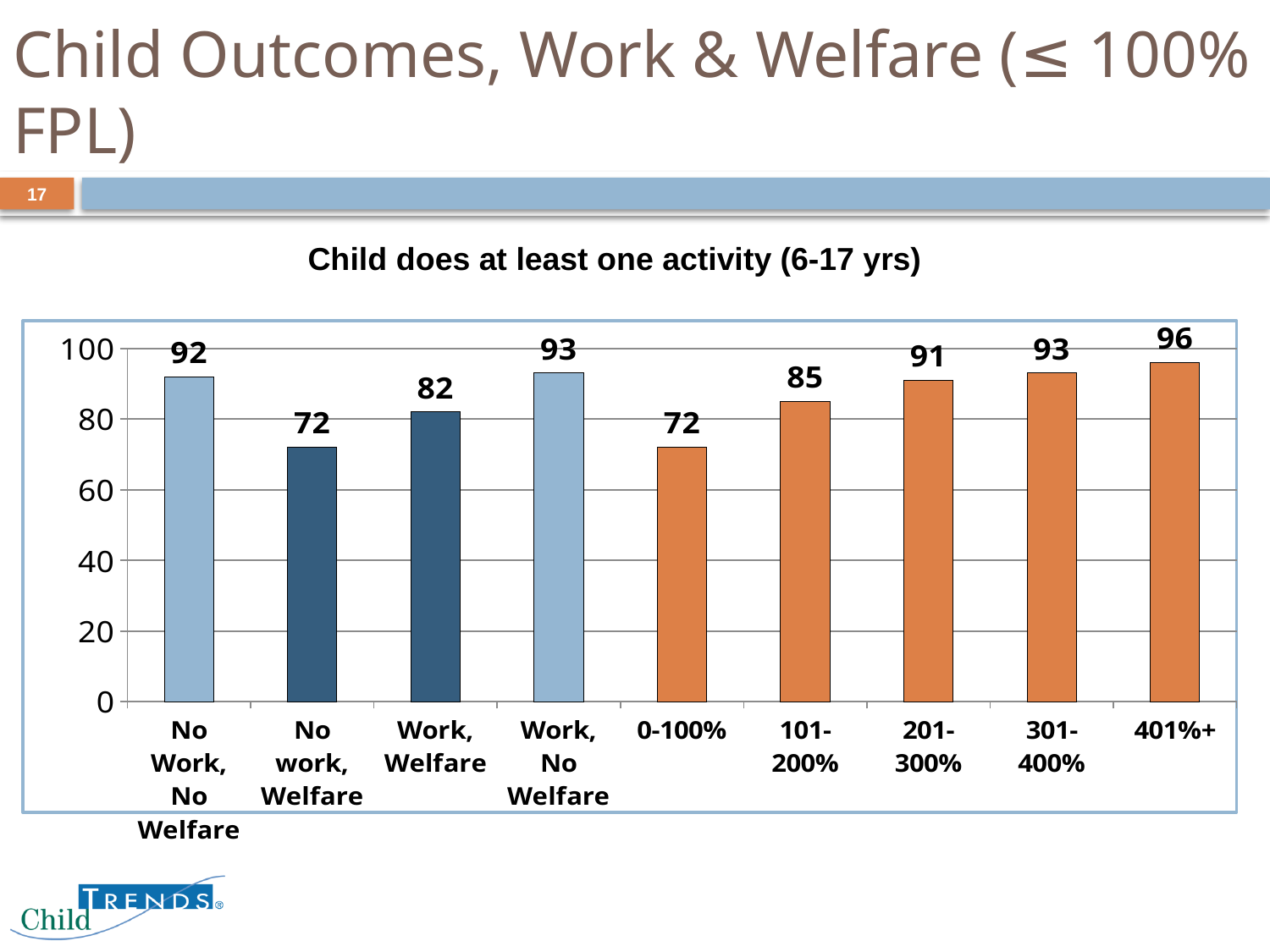
Which category has the highest value? 401%+ What kind of chart is shown on the slide? bar chart How many categories are shown on the x axis? 9 What is the value for the 'Work, Welfare' category? 82 What is the value for the 'No work, Welfare' category? 72 Is the value for '101-200%' greater or less than 80? greater What is the title of the chart? Child does at least one activity (6-17 yrs) What is the difference between the values for 'Work, No Welfare' and 'No work, Welfare'? 21 What is the difference between the values for '401%+' and '0-100%'? 24 Do the values rise or fall across the income categories from '0-100%' to '401%+'? rise Which is larger, the value for 'No Work, No Welfare' or the value for 'Work, Welfare'? No Work, No Welfare What is the value for the '401%+' category? 96